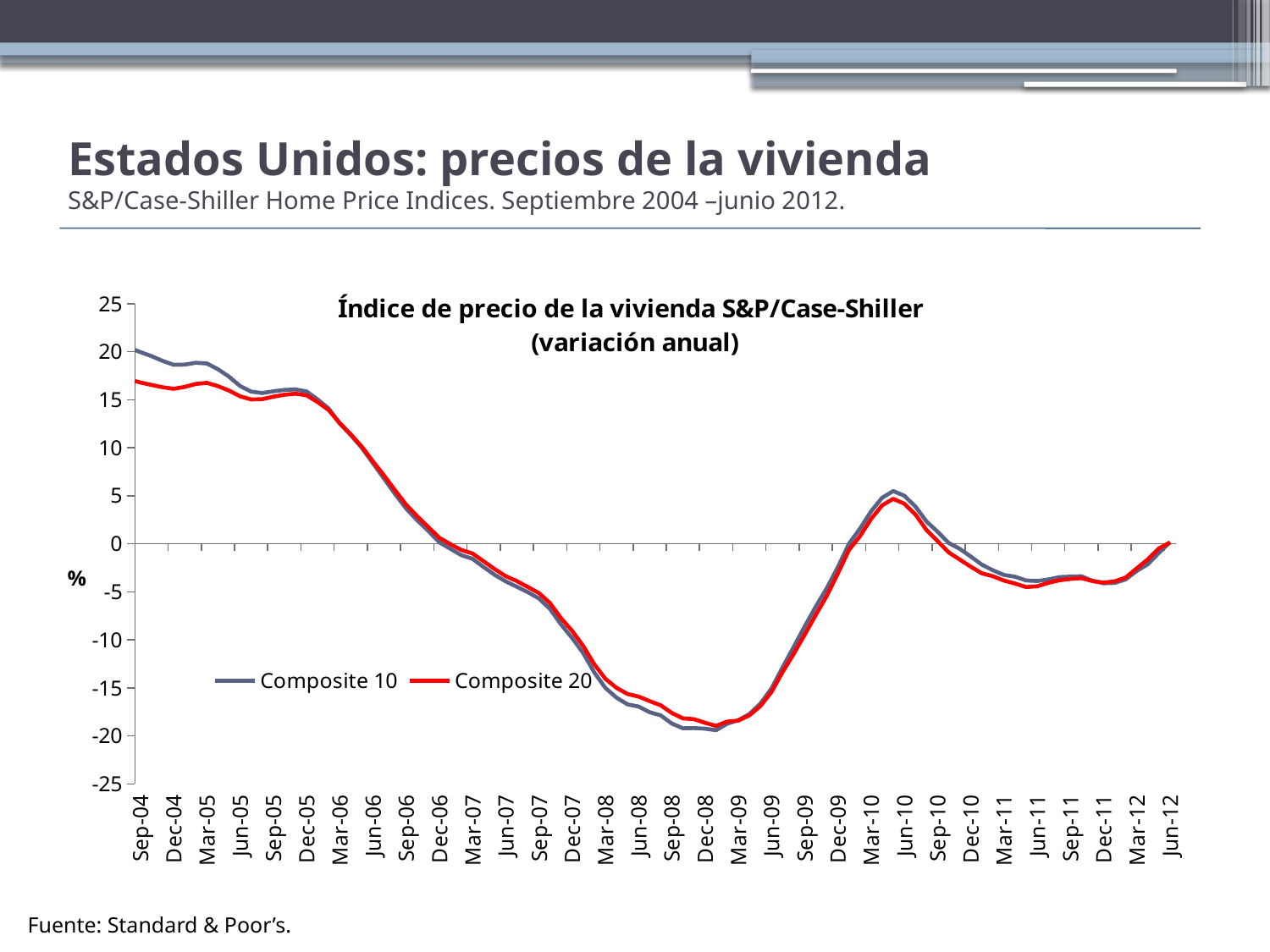
How many series does the legend list? 2 Is the value for Composite 20 at Dec-08 greater or less than -15? less At which date does Composite 10 reach its highest value? Sep-04 What are the two series named in the legend? Composite 10 and Composite 20 What kind of chart is shown on the slide? Line chart What is the title of the chart? Índice de precio de la vivienda S&P/Case-Shiller (variación anual) Is the value for Composite 10 at Mar-06 greater or less than 10? greater Do the values of Composite 10 rise or fall between Sep-04 and Dec-08? Fall Is the value for Composite 20 at Jun-11 greater or less than 0? less At Sep-04, which series has the higher value, Composite 10 or Composite 20? Composite 10